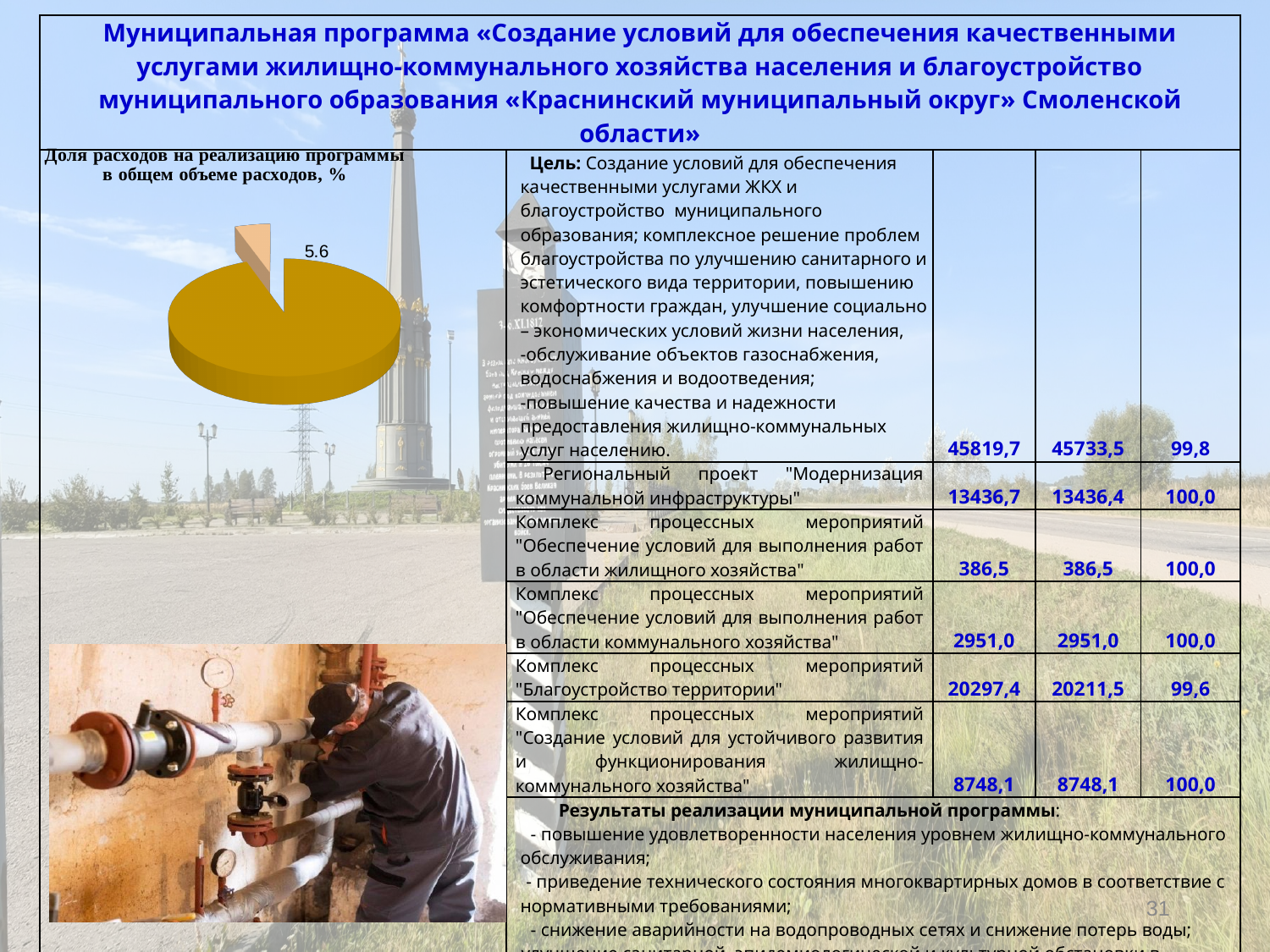
What share of total expenditures does the program account for, according to the pie chart? 5.6% What colour is the large slice of the pie chart? gold (yellow) How many slices does the pie chart have? 2 What value is printed on the exploded (separated) slice of the pie chart? 5.6 Is the exploded slice labelled 5.6 the larger or the smaller slice of the pie chart? smaller What is the title of the pie chart? Доля расходов на реализацию программы в общем объеме расходов, % What type of chart is shown on the left of the slide? pie chart